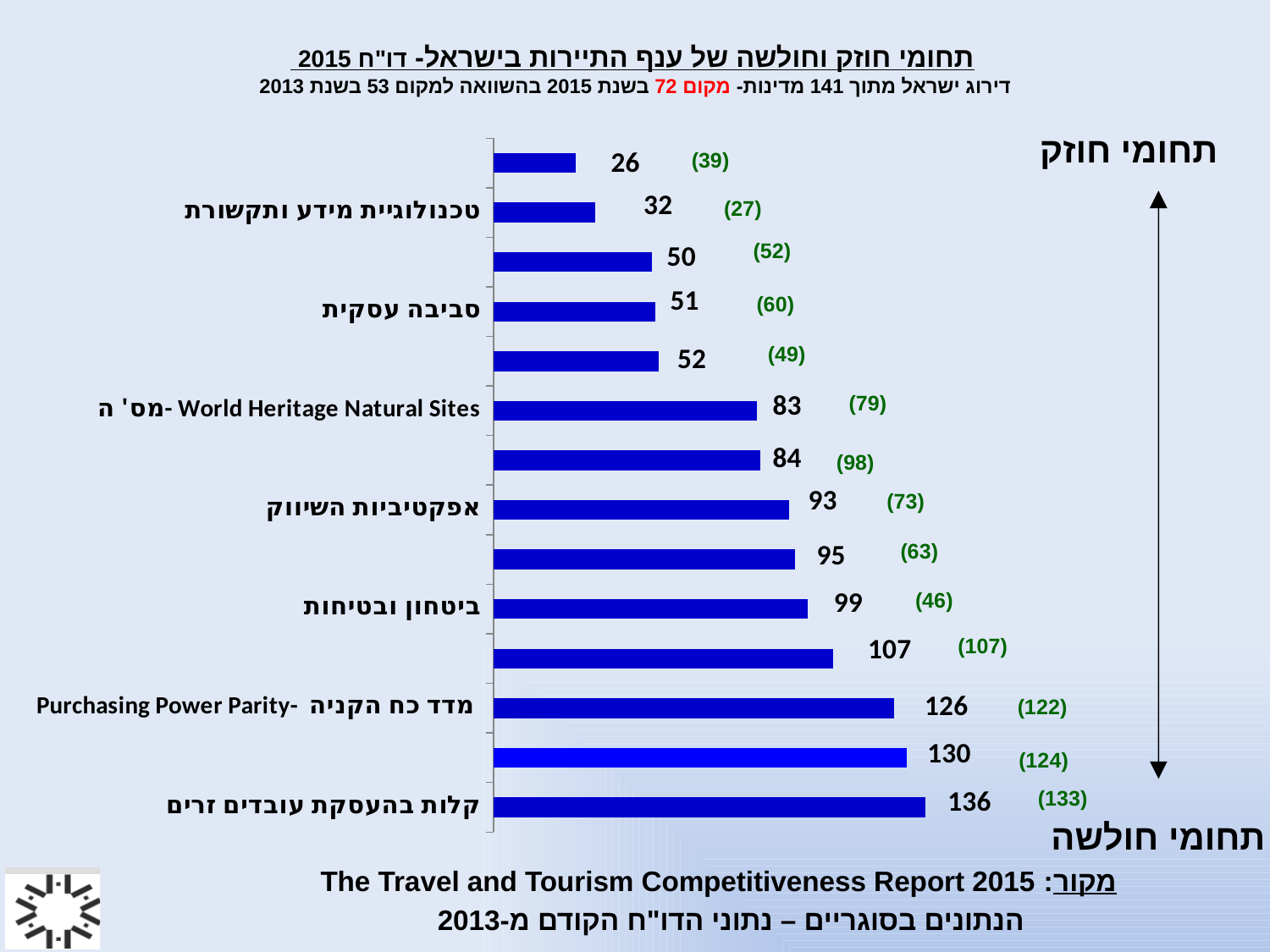
What is the value of the bar for טכנולוגיית מידע ותקשורת? 32 What is the value of the bar for אפקטיביות השיווק? 93 Which category has the highest value in the chart? קלות בהעסקת עובדים זרים What is the value of the bar for ביטחון ובטיחות? 99 How many bars are plotted in the chart? 14 What is the value of the bar for מדד כח הקניה - Purchasing Power Parity? 126 What kind of chart is shown on the slide? bar chart Which has a larger value, ביטחון ובטיחות or סביבה עסקית? ביטחון ובטיחות What is the value of the bar for World Heritage Natural Sites? 83 What is the difference between the value for קלות בהעסקת עובדים זרים and the value for ביטחון ובטיחות? 37 What is the lowest value shown on any bar in the chart? 26 What is the value of the bar for סביבה עסקית? 51